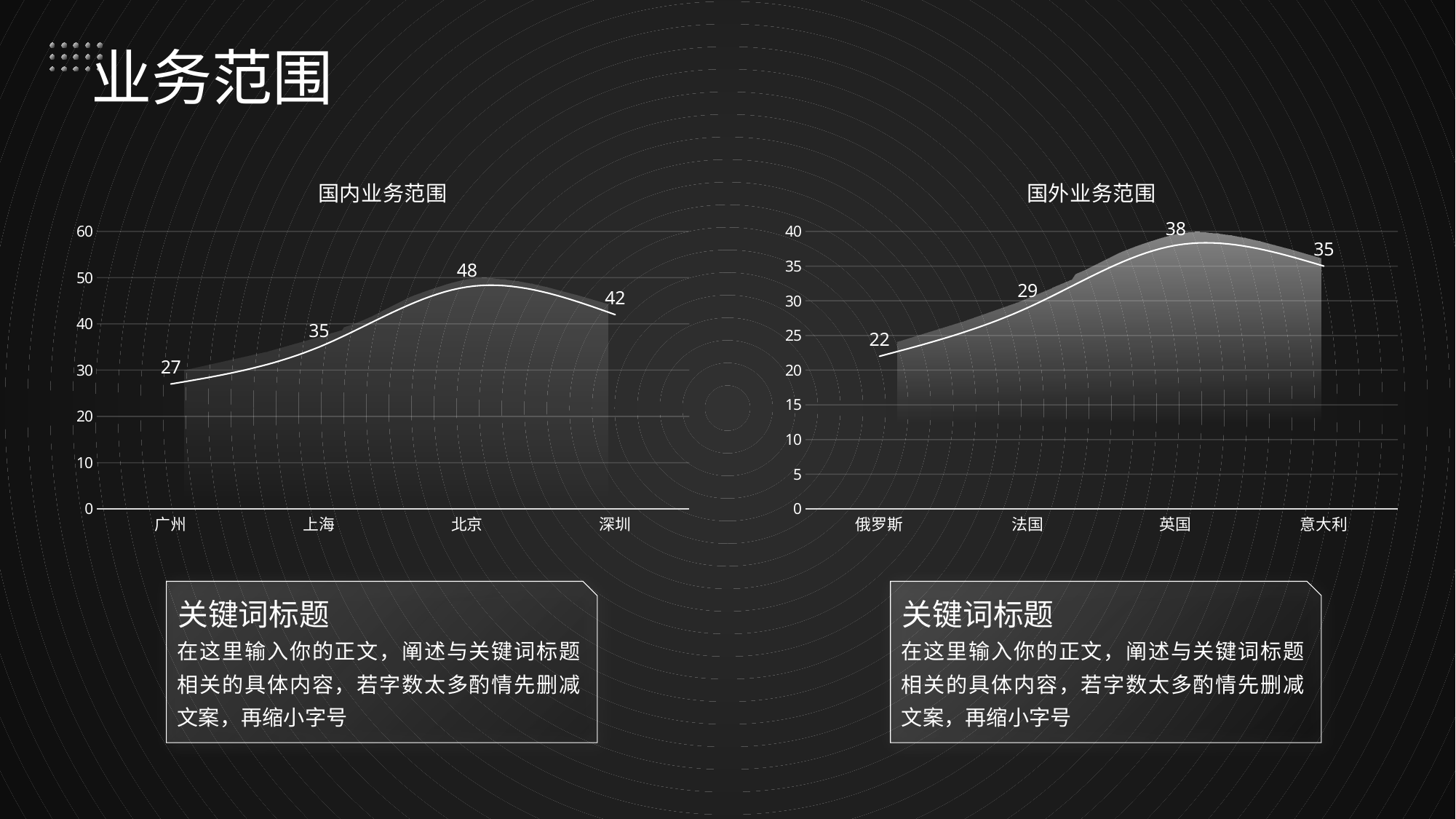
In the 国外业务范围 chart, what is the difference between the values for 英国 and 意大利? 3 In the 国内业务范围 chart, how many categories are shown on the x axis? 4 In the 国内业务范围 chart, what is the value for 北京? 48 In the 国外业务范围 chart, which category has the highest value? 英国 What is the title of the chart on the left side of the slide? 国内业务范围 What kind of chart is the 国外业务范围 chart? Line chart In the 国外业务范围 chart, what is the value for 俄罗斯? 22 In the 国外业务范围 chart, what is the value for 法国? 29 In the 国内业务范围 chart, what is the difference between the values for 北京 and 广州? 21 In the 国内业务范围 chart, do the values rise or fall from 广州 to 北京? Rise In the 国内业务范围 chart, which is larger, the value for 上海 or the value for 深圳? 深圳 In the 国内业务范围 chart, which category has the lowest value? 广州